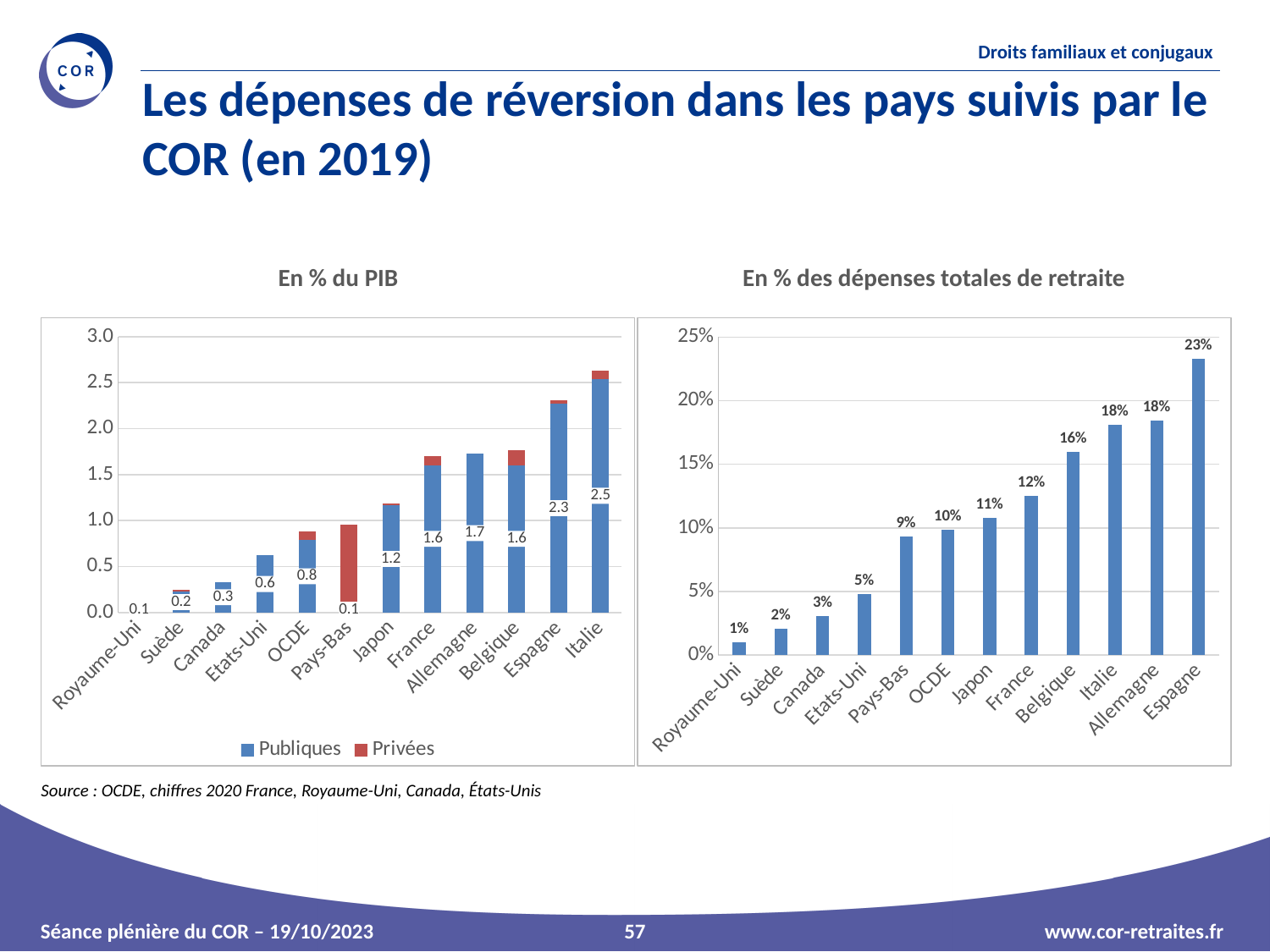
In the chart 'En % des dépenses totales de retraite', which country has the lowest value? Royaume-Uni In the 'En % du PIB' chart, which has the larger Publiques value, France or Japon? France In the chart 'En % des dépenses totales de retraite', what is the difference between Belgique and France? 4 percentage points What kind of chart is the 'En % du PIB' chart on the left? Stacked bar chart What are the two legend entries of the 'En % du PIB' chart? Publiques and Privées In the chart 'En % des dépenses totales de retraite', do the values rise or fall from left to right? Rise In the 'En % du PIB' chart, what is the Publiques value for Allemagne? 1.7 In the chart 'En % des dépenses totales de retraite', which country has the highest value? Espagne How many countries or groups are shown in the chart 'En % des dépenses totales de retraite'? 12 In the chart 'En % des dépenses totales de retraite', what is the value for Espagne? 23% In the 'En % du PIB' chart, is the total bar for Pays-Bas greater or less than 0.5? greater How many series does the legend of the 'En % du PIB' chart list? 2